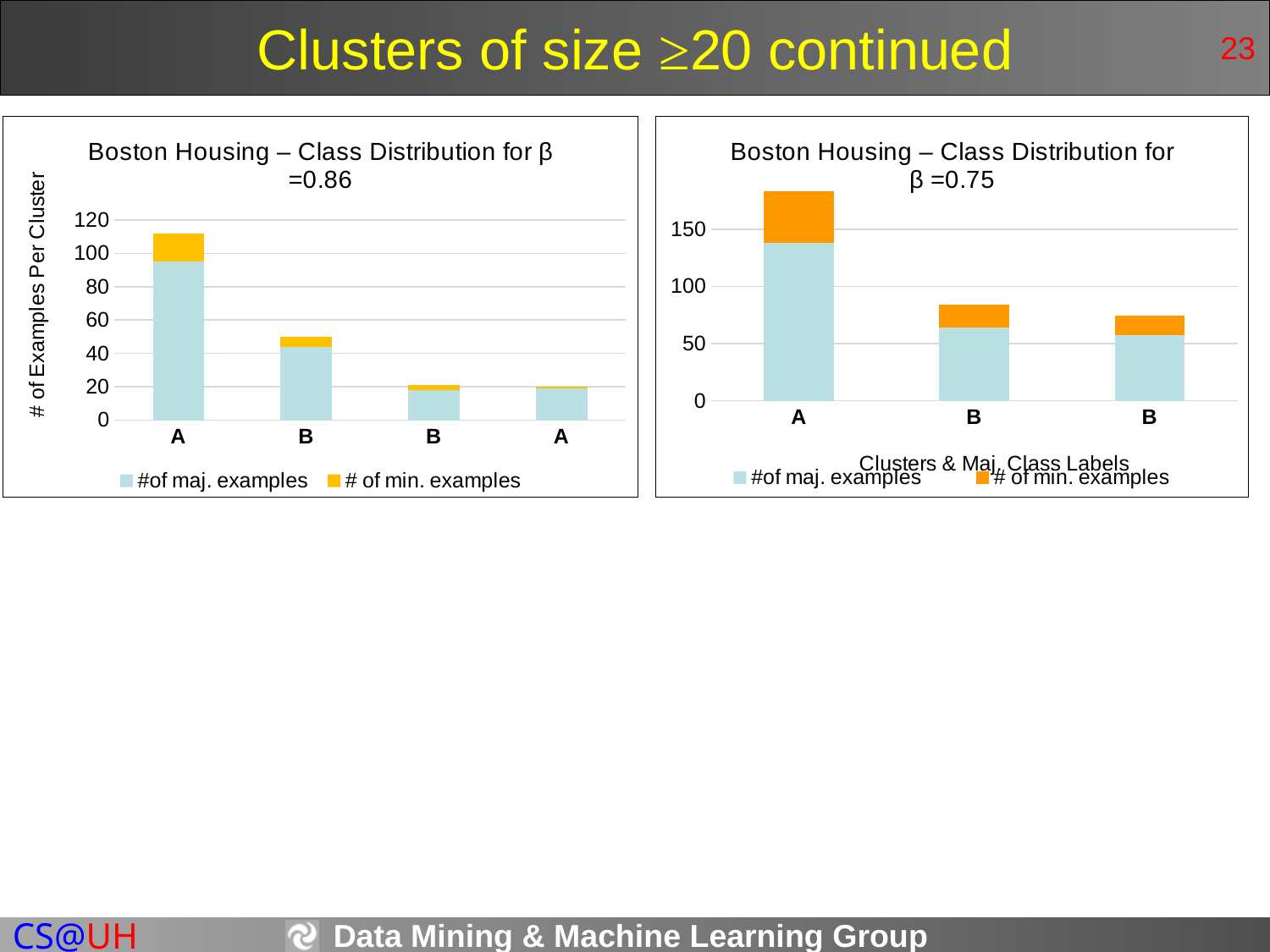
What is the y-axis title of the left chart (β =0.86)? # of Examples Per Cluster In the left chart (β =0.86), is the total height of the second bar (B) greater or less than 40? greater In the left chart (β =0.86), which bar is the tallest? the first bar, A What are the two legend entries of the right chart (β =0.75)? #of maj. examples and # of min. examples How many bars does the right chart (β =0.75) show? 3 How many bars does the left chart (β =0.86) show? 4 How many series does the legend of the left chart (β =0.86) list? 2 What kind of chart is the left chart, 'Boston Housing – Class Distribution for β =0.86'? stacked bar chart In the left chart (β =0.86), is the total height of the first bar (A) greater or less than 100? greater In the right chart (β =0.75), is the total height of bar A greater or less than 150? greater In the right chart (β =0.75), which bar is the tallest? A